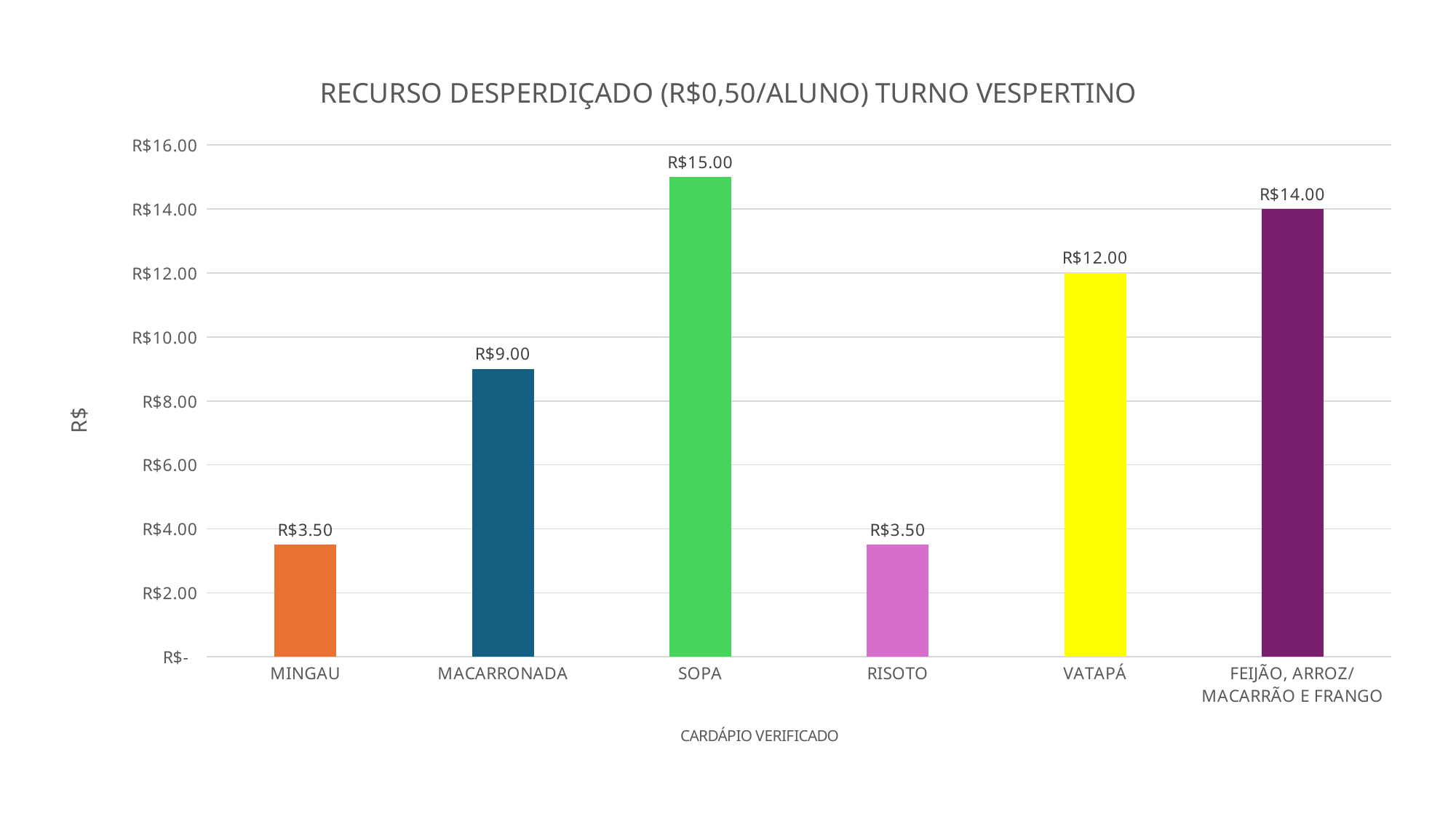
Which is larger, the value for MACARRONADA or the value for RISOTO? MACARRONADA How many categories are shown on the x axis? 6 What is the value for FEIJÃO, ARROZ/ MACARRÃO E FRANGO? R$14.00 Is the value for VATAPÁ greater or less than R$10.00? greater What is the value for VATAPÁ? R$12.00 What is the difference between the values for SOPA and MINGAU? R$11.50 What is the difference between the values for FEIJÃO, ARROZ/ MACARRÃO E FRANGO and VATAPÁ? R$2.00 Which category has the highest value? SOPA What is the value for SOPA? R$15.00 What is the value for MACARRONADA? R$9.00 What is the title of the chart? RECURSO DESPERDIÇADO (R$0,50/ALUNO) TURNO VESPERTINO What kind of chart is this? bar chart